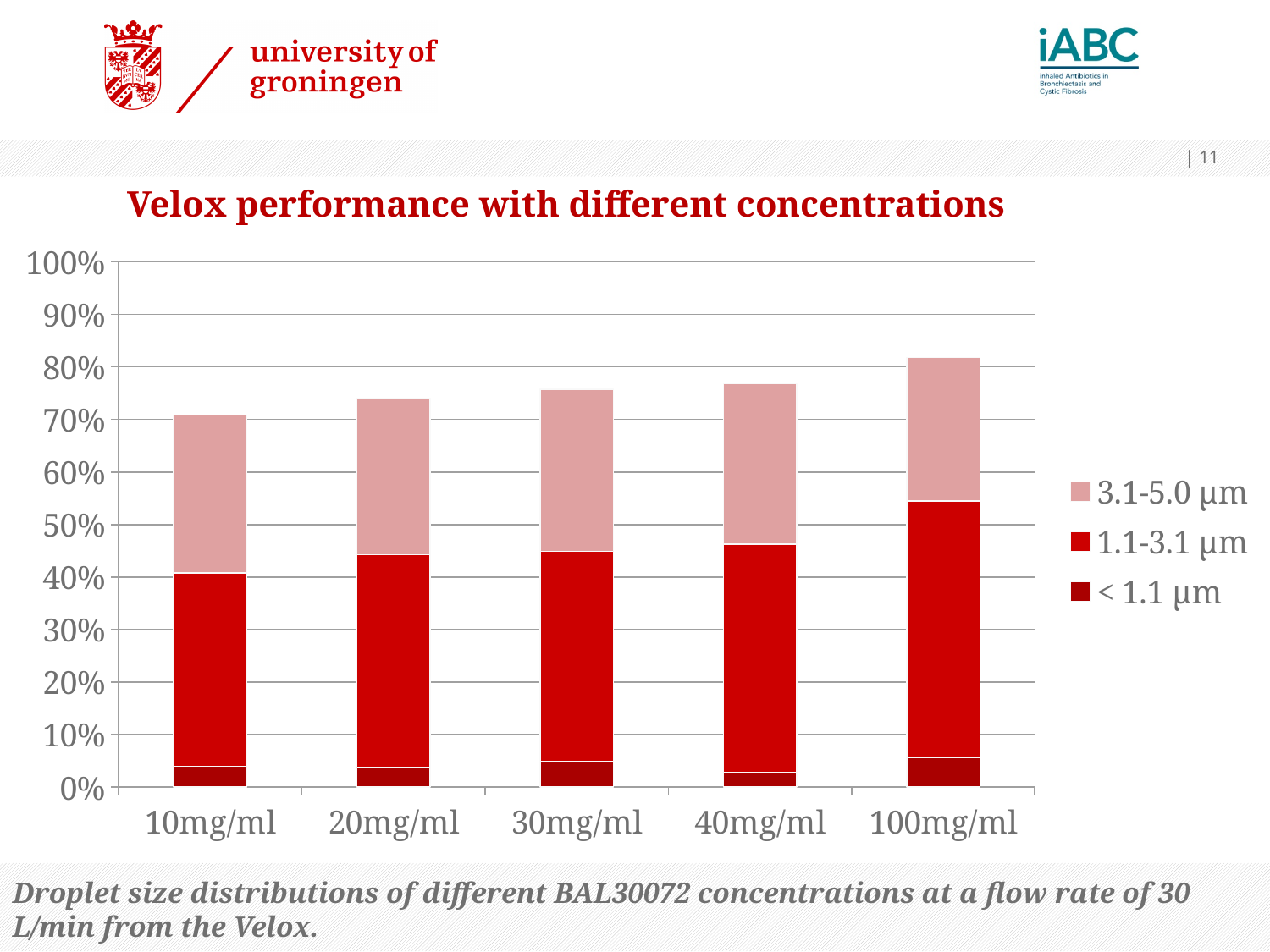
Which legend entry is shown in the lightest pink colour? 3.1-5.0 µm Which has the larger total stacked bar, 10mg/ml or 100mg/ml? 100mg/ml Do the total bar heights rise or fall as concentration increases along the x axis? rise How many series does the legend list? 3 What kind of chart is shown on the slide? stacked bar chart What is the title of the chart? Velox performance with different concentrations How many concentration categories are shown on the x axis? 5 Is the total stacked bar for 20mg/ml greater or less than 70%? greater Which concentration has the lowest total stacked bar? 10mg/ml Is the total stacked bar for 100mg/ml greater or less than 80%? greater Is the total stacked bar for 40mg/ml greater or less than 80%? less Which concentration has the highest total stacked bar? 100mg/ml